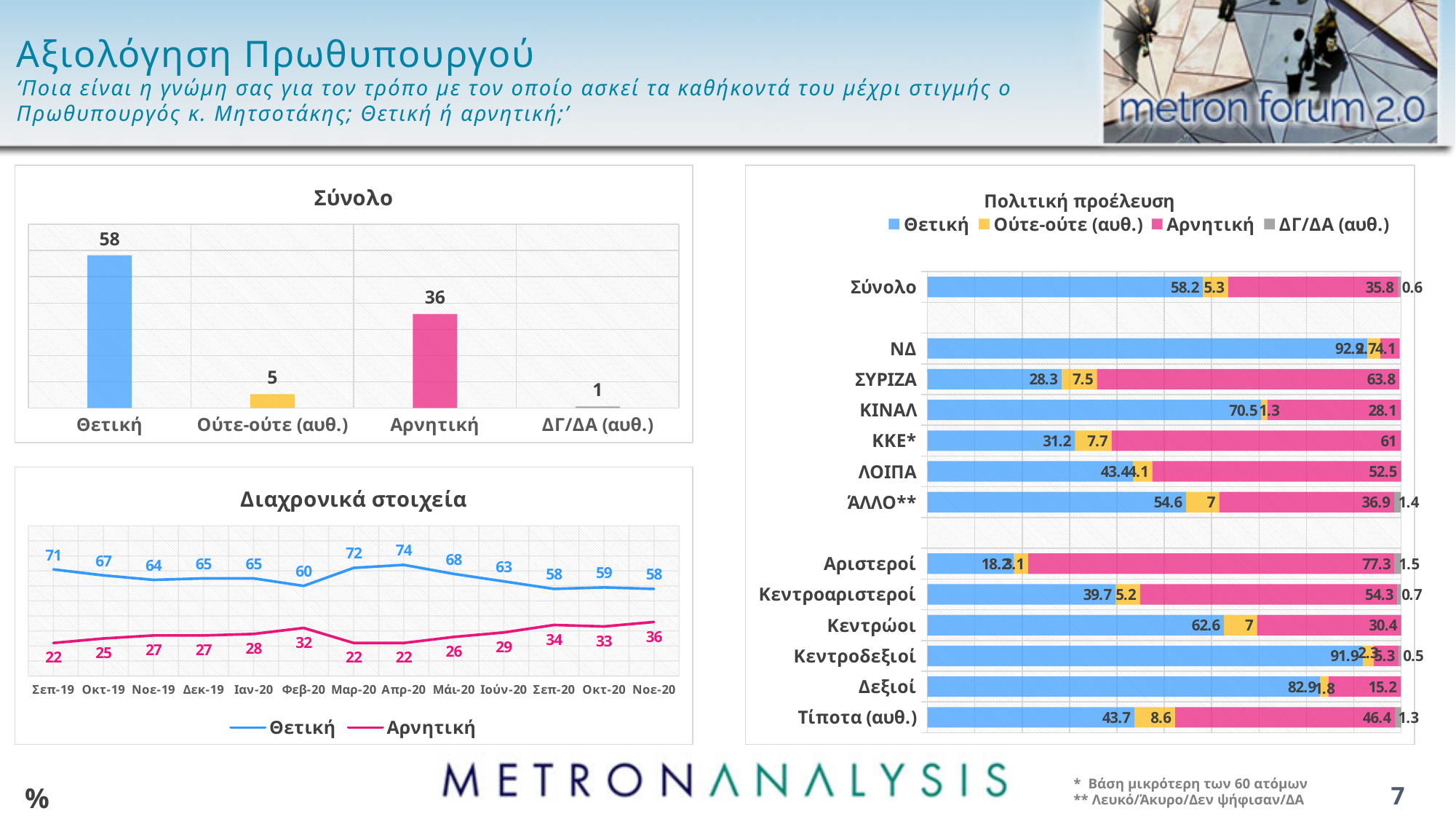
In the 'Σύνολο' chart, which category has the lowest value? ΔΓ/ΔΑ (αυθ.) In the 'Σύνολο' chart, what is the value for Θετική? 58 In the 'Πολιτική προέλευση' chart, which is larger: the Αρνητική value for Αριστεροί or for Κεντροαριστεροί? Αριστεροί In the 'Πολιτική προέλευση' chart, what is the Αρνητική value for ΣΥΡΙΖΑ? 63.8 In the 'Διαχρονικά στοιχεία' chart, what kind of chart is it? line chart In the 'Διαχρονικά στοιχεία' chart, what is the Αρνητική value for Φεβ-20? 32 In the 'Σύνολο' chart, how many categories are shown? 4 In the 'Διαχρονικά στοιχεία' chart, how many series does the legend list? 2 In the 'Πολιτική προέλευση' chart, what is the Θετική value for Κεντρώοι? 62.6 In the 'Πολιτική προέλευση' chart, how many series does the legend list? 4 In the 'Σύνολο' chart, what is the difference between Θετική and Αρνητική? 22 In the 'Διαχρονικά στοιχεία' chart, what is the Θετική value for Απρ-20? 74